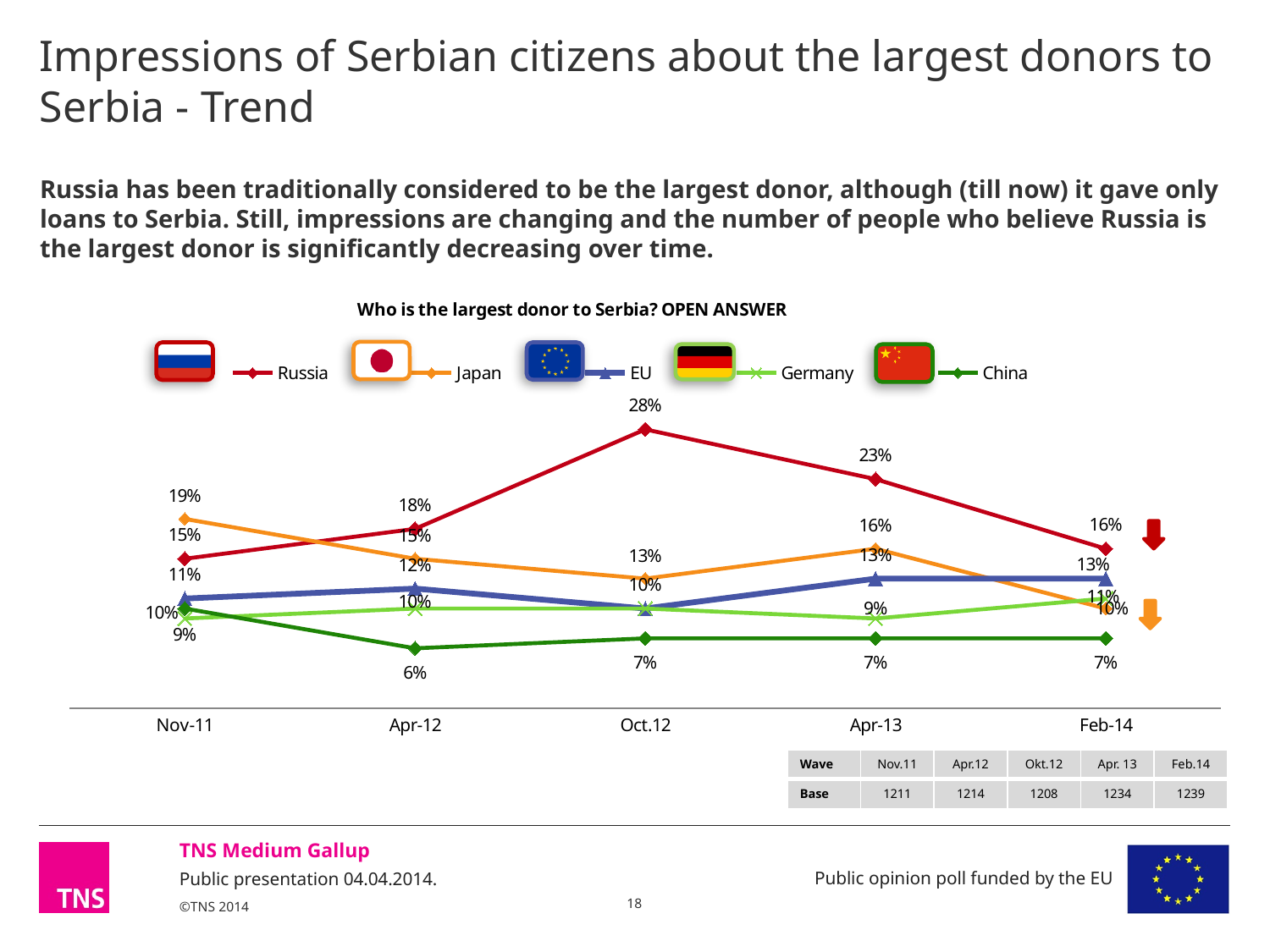
What type of chart is shown on the slide? Line chart At which time point does China have its lowest value? Apr-12 What is the difference between Russia's value at Oct.12 and at Feb-14? 12 percentage points Does the value for Russia rise or fall from Oct.12 to Feb-14? Fall What is the value for Japan at Nov-11? 19% How many series does the chart legend list? 5 What is the value for China at Apr-12? 6% What is the value for Russia at Oct.12? 28% What is the value for Russia at Apr-13? 23% Which series has the higher value at Nov-11, Russia or Japan? Japan At which time point does Russia reach its highest value? Oct.12 How many time points are shown on the x axis of the chart? 5